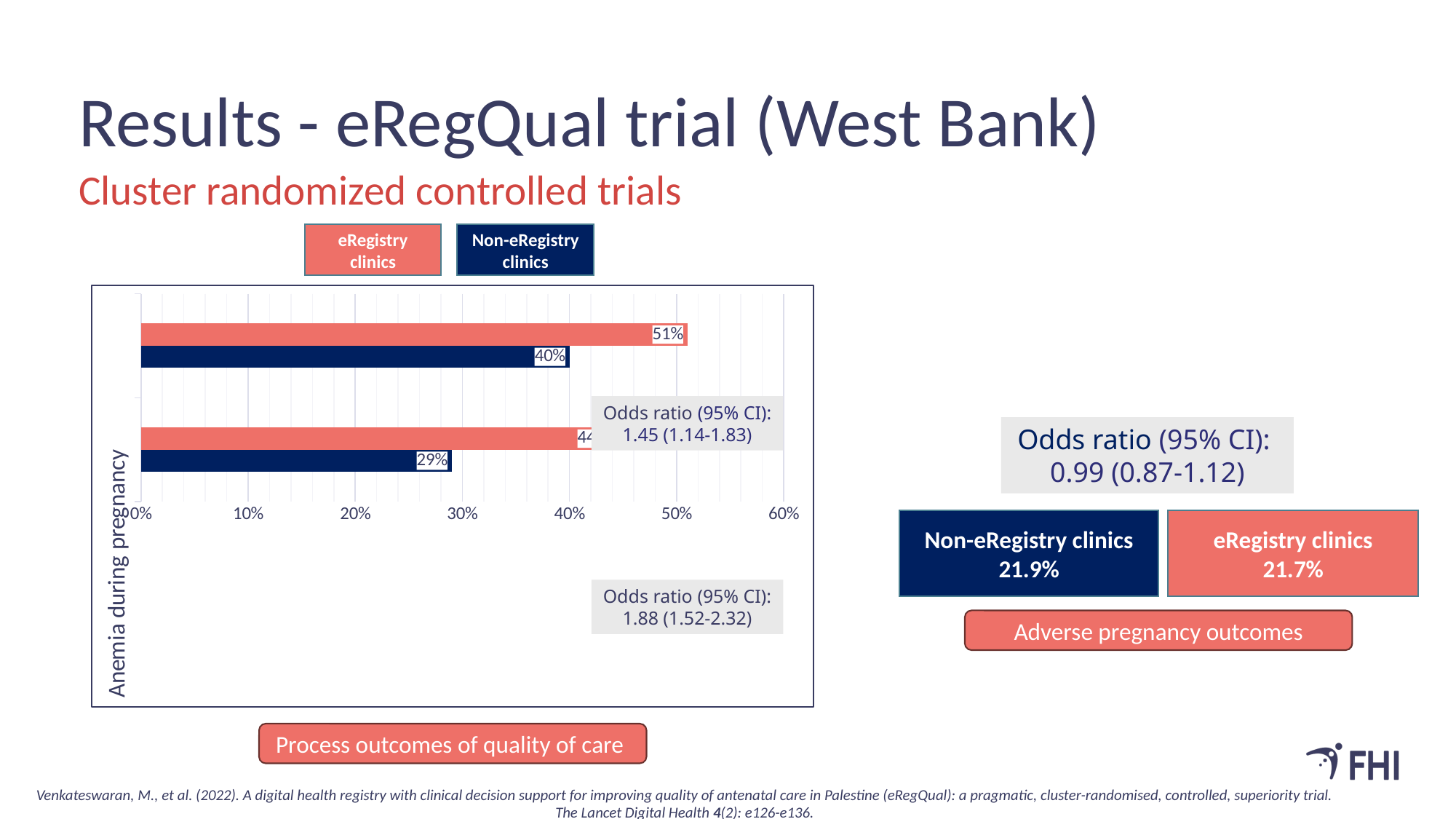
In the top pair of bars, what is the value for eRegistry clinics? 51% In the lower pair of bars, is the value for eRegistry clinics greater or less than 40%? greater How many series does the chart's legend list? 2 What kind of chart is shown on the slide? Bar chart In the top pair of bars, what is the value for Non-eRegistry clinics? 40% In the lower pair of bars, what is the value for Non-eRegistry clinics? 29% Which bar in the chart has the lowest value? Non-eRegistry clinics in the lower pair (29%) How many bars are plotted in the chart in total? 4 In the top pair of bars, what is the difference between the eRegistry clinics value and the Non-eRegistry clinics value? 11 percentage points In the top pair of bars, which series has the larger value, eRegistry clinics or Non-eRegistry clinics? eRegistry clinics What is the title shown on the chart's vertical axis? Anemia during pregnancy Which bar in the chart has the highest value? eRegistry clinics in the top pair (51%)